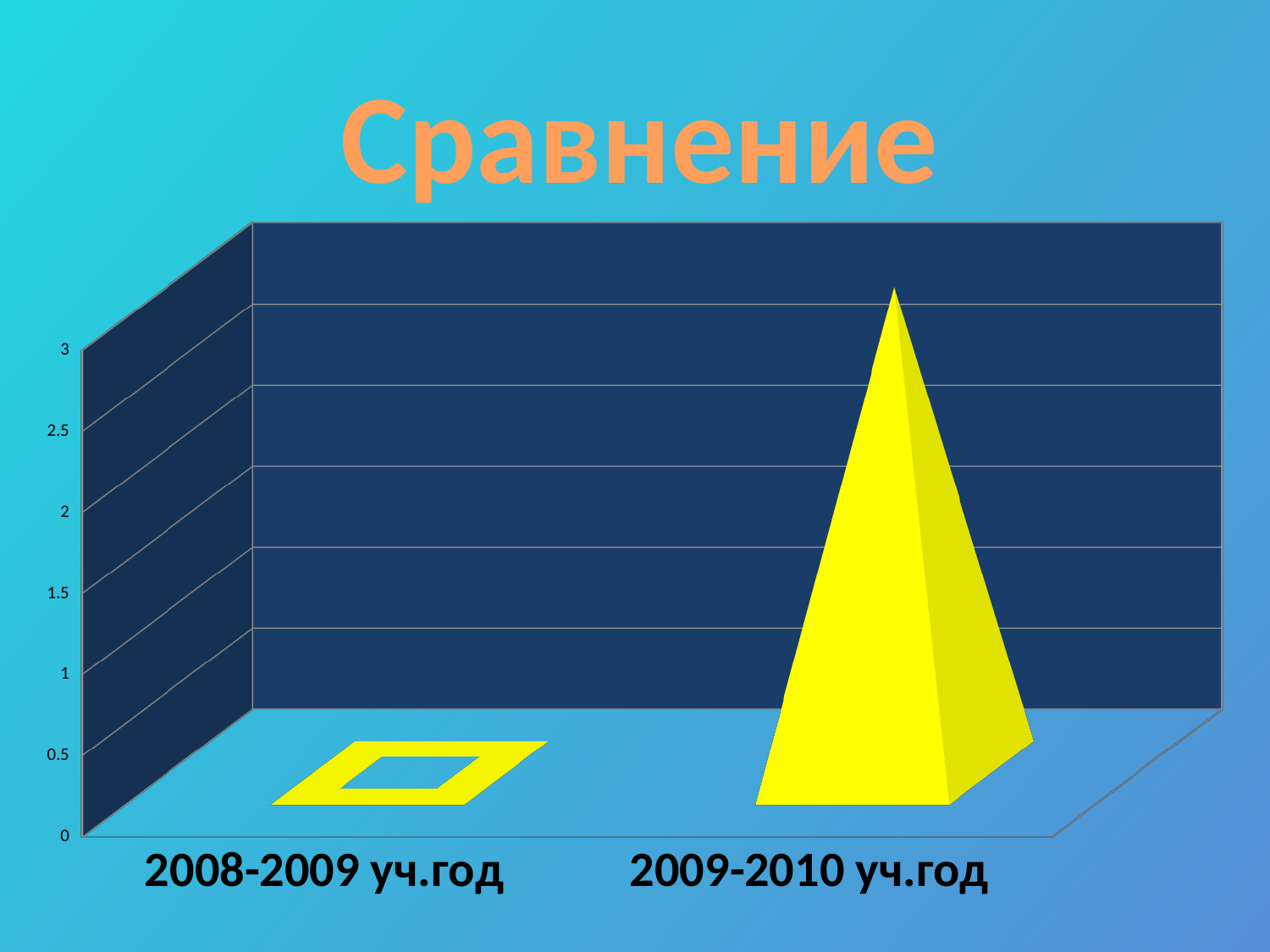
Which category has the highest value in the chart? 2009-2010 уч.год Is the value for 2008-2009 уч.год greater or less than 1? less Is the value for 2009-2010 уч.год greater or less than 2? greater Which category has the lowest value in the chart? 2008-2009 уч.год How many categories are shown on the x axis of the chart? 2 What kind of chart is shown on the slide? bar chart What is the value for 2008-2009 уч.год in the chart? 0 What is the title of the chart on the slide? Сравнение What is the highest tick value shown on the vertical axis of the chart? 3 Which is larger, the value for 2008-2009 уч.год or the value for 2009-2010 уч.год? 2009-2010 уч.год Do the values rise or fall from 2008-2009 уч.год to 2009-2010 уч.год? rise